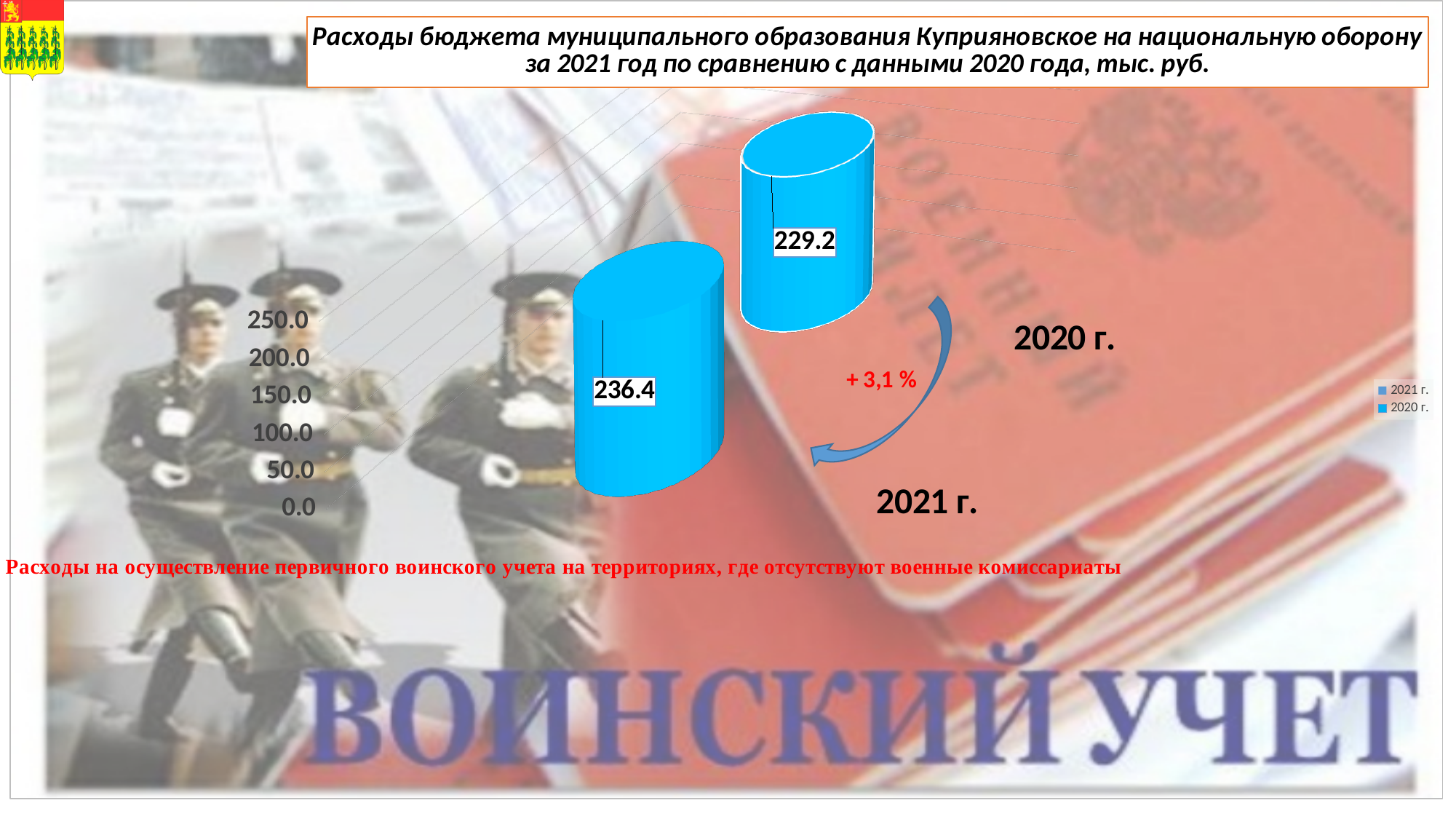
In what units are the values on the chart expressed, according to the title? тыс. руб. How many entries does the legend list? 2 What is the value for 2021 г.? 236.4 Which year has the higher value, 2020 г. or 2021 г.? 2021 г. How many bars are plotted on the chart? 2 Which year has the lower value? 2020 г. Is the value for 2020 г. greater or less than 200.0? greater Is the value for 2021 г. larger or smaller than the value for 2020 г.? larger What percentage change from 2020 to 2021 is annotated on the chart? + 3,1 % What is the difference between the 2021 г. value and the 2020 г. value? 7.2 What kind of chart is shown on the slide? bar chart What is the value for 2020 г.? 229.2